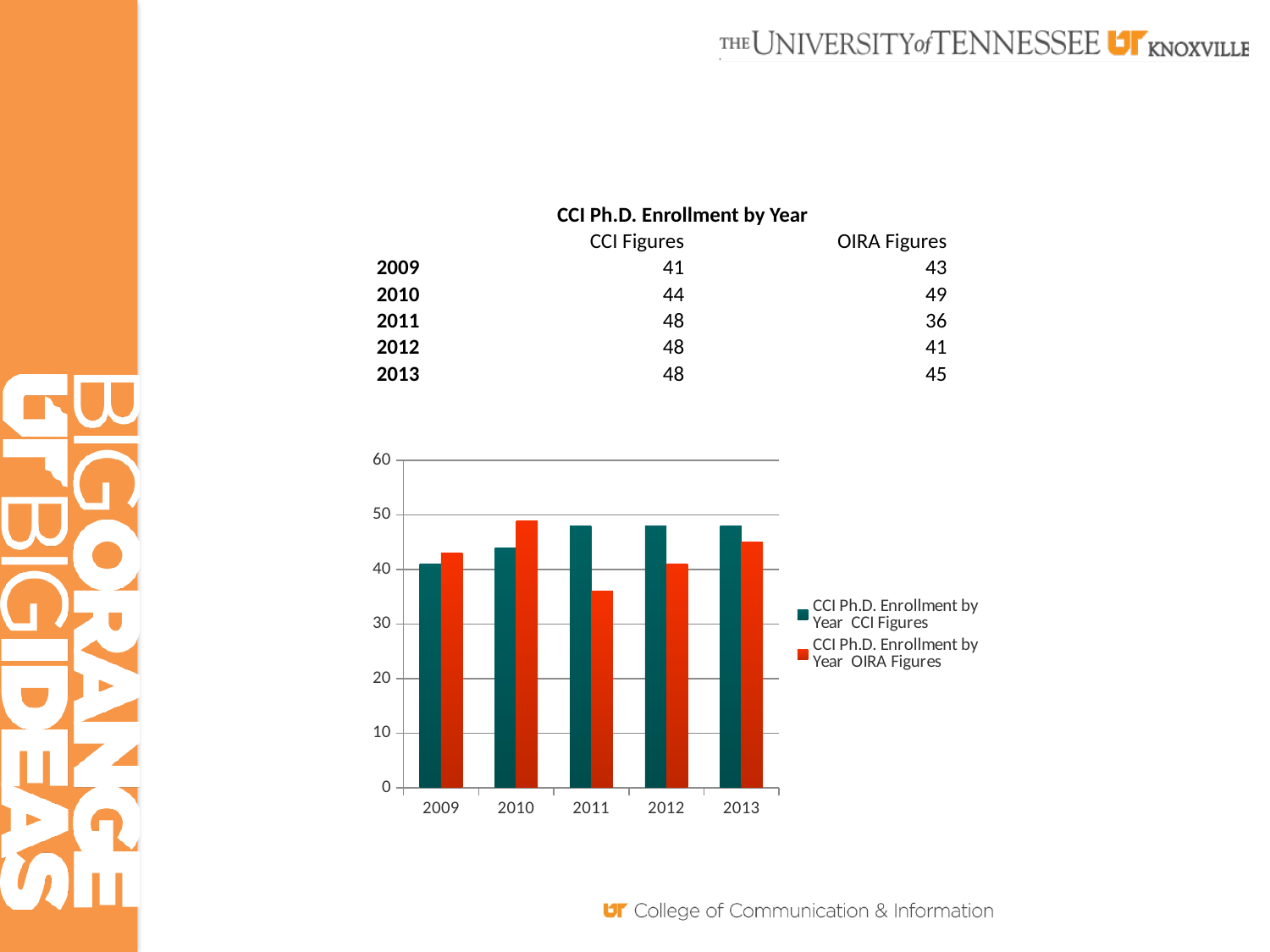
Is the OIRA Figures value for 2011 greater or less than 40? less Do the CCI Figures values rise or fall from 2009 to 2011? rise What is the CCI Figures value for 2011? 48 Which year has the lowest OIRA Figures value? 2011 What colour are the bars for the OIRA Figures series? red-orange What is the OIRA Figures value for 2010? 49 How many series does the chart's legend list? 2 Which year has the highest OIRA Figures value? 2010 What kind of chart is shown on the slide? bar chart What is the difference between the OIRA Figures and CCI Figures values for 2011? 12 How many years are shown on the x axis of the chart? 5 For 2012, which is larger: the CCI Figures value or the OIRA Figures value? CCI Figures